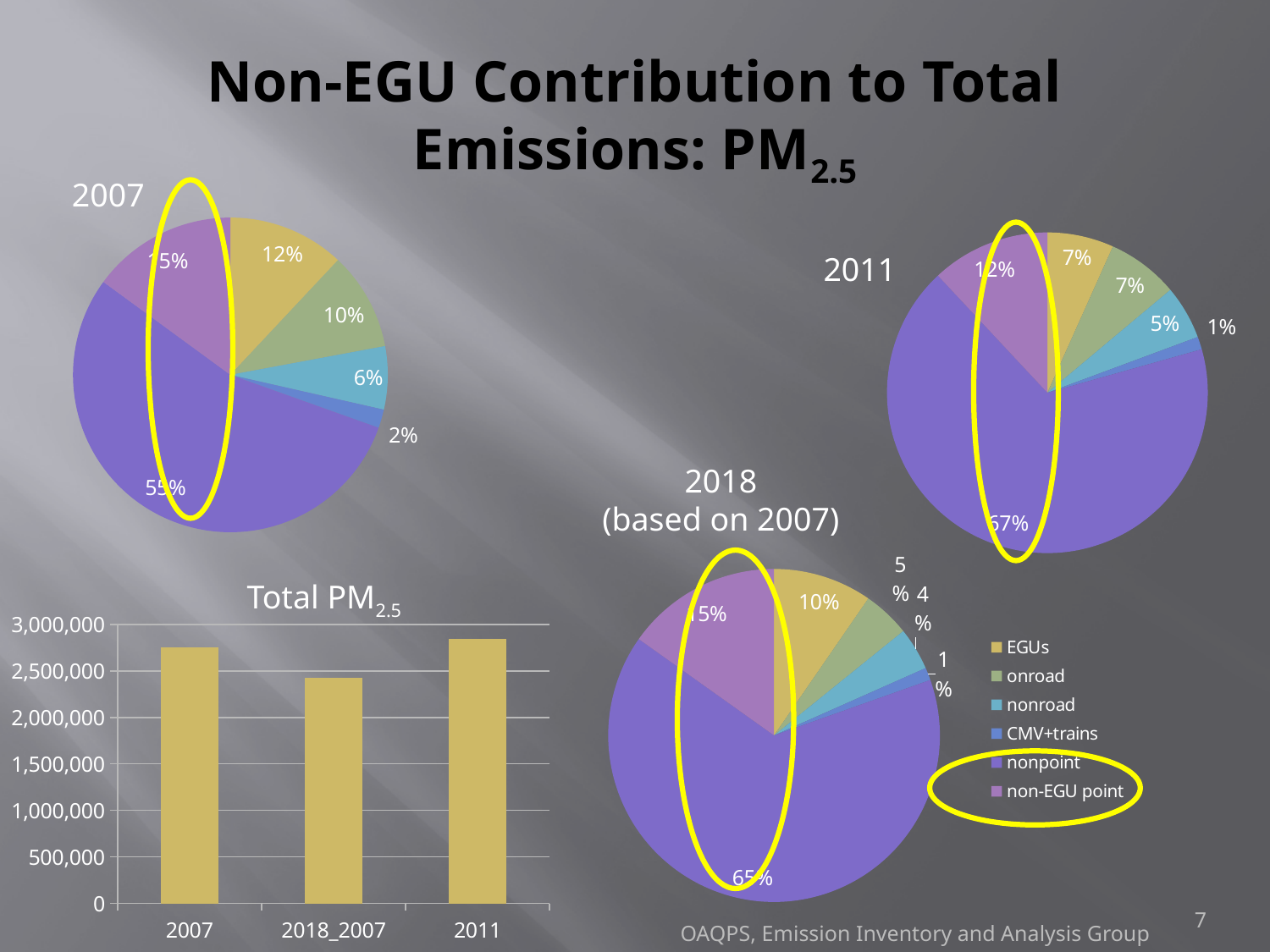
In the 2018 (based on 2007) pie chart, what share of emissions is nonpoint? 65% How many entries does the legend for the pie charts list? 6 How many categories are shown in the Total PM2.5 bar chart? 3 In the Total PM2.5 bar chart, which category has the lowest value? 2018_2007 In the 2007 pie chart, what share of emissions comes from EGUs? 12% In the 2007 pie chart, what share of emissions is nonpoint? 55% In the Total PM2.5 bar chart, is the value for 2011 greater or less than 2,500,000? greater In the 2011 pie chart, what share of emissions is nonpoint? 67% In the 2018 (based on 2007) pie chart, what share of emissions comes from EGUs? 10% In the 2007 pie chart, which is larger, the EGUs slice or the onroad slice? EGUs In the 2011 pie chart, what share of emissions comes from CMV+trains? 1% In the Total PM2.5 bar chart, is the value for 2018_2007 greater or less than 2,500,000? less